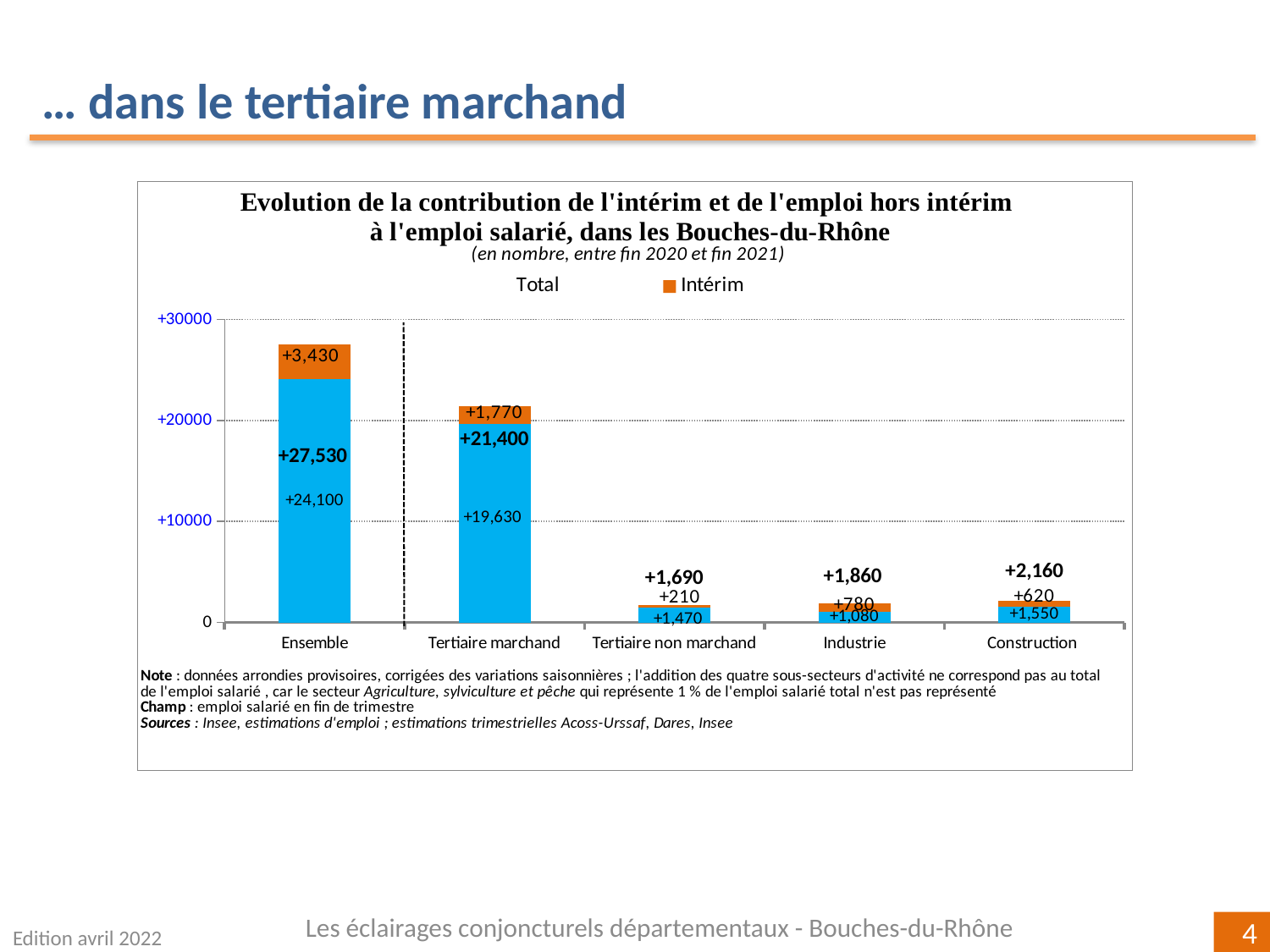
What is the total shown for Industrie? +1,860 Which category has the lowest total? Tertiaire non marchand What is the Intérim value for Construction? +620 Which category has the highest total? Ensemble What kind of chart is shown? Stacked bar chart What is the difference between the totals for Ensemble and Tertiaire marchand? 6,130 What is the Intérim value for Ensemble? +3,430 Which has a larger Intérim value, Industrie or Construction? Industrie Is the total for Tertiaire marchand greater or less than 20000? greater How many series does the legend list? 2 How many categories are shown on the x axis? 5 What is the total shown above the bar for Tertiaire marchand? +21,400